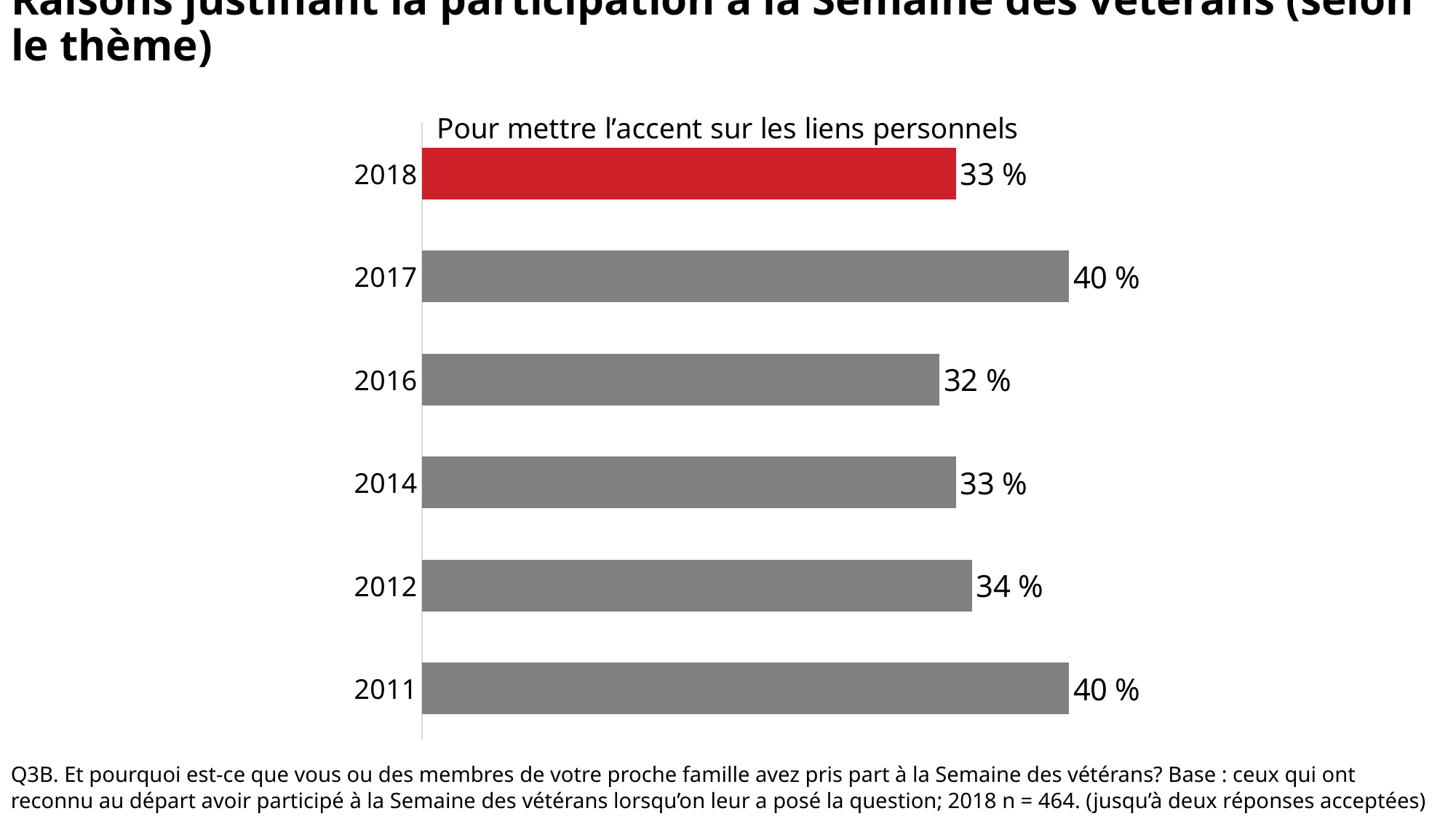
Which is larger, the value for 2011 or the value for 2014? 2011 Which year has the lowest value? 2016 What kind of chart is shown on the slide? Bar chart What is the title of the chart? Pour mettre l'accent sur les liens personnels What is the value for 2016? 32 % What is the value for 2018? 33 % What is the difference between the values for 2012 and 2016? 2 % What is the value for 2012? 34 % How many years are shown in the chart? 6 What is the difference between the values for 2017 and 2018? 7 % Which year's bar is coloured red? 2018 What is the value for 2017? 40 %